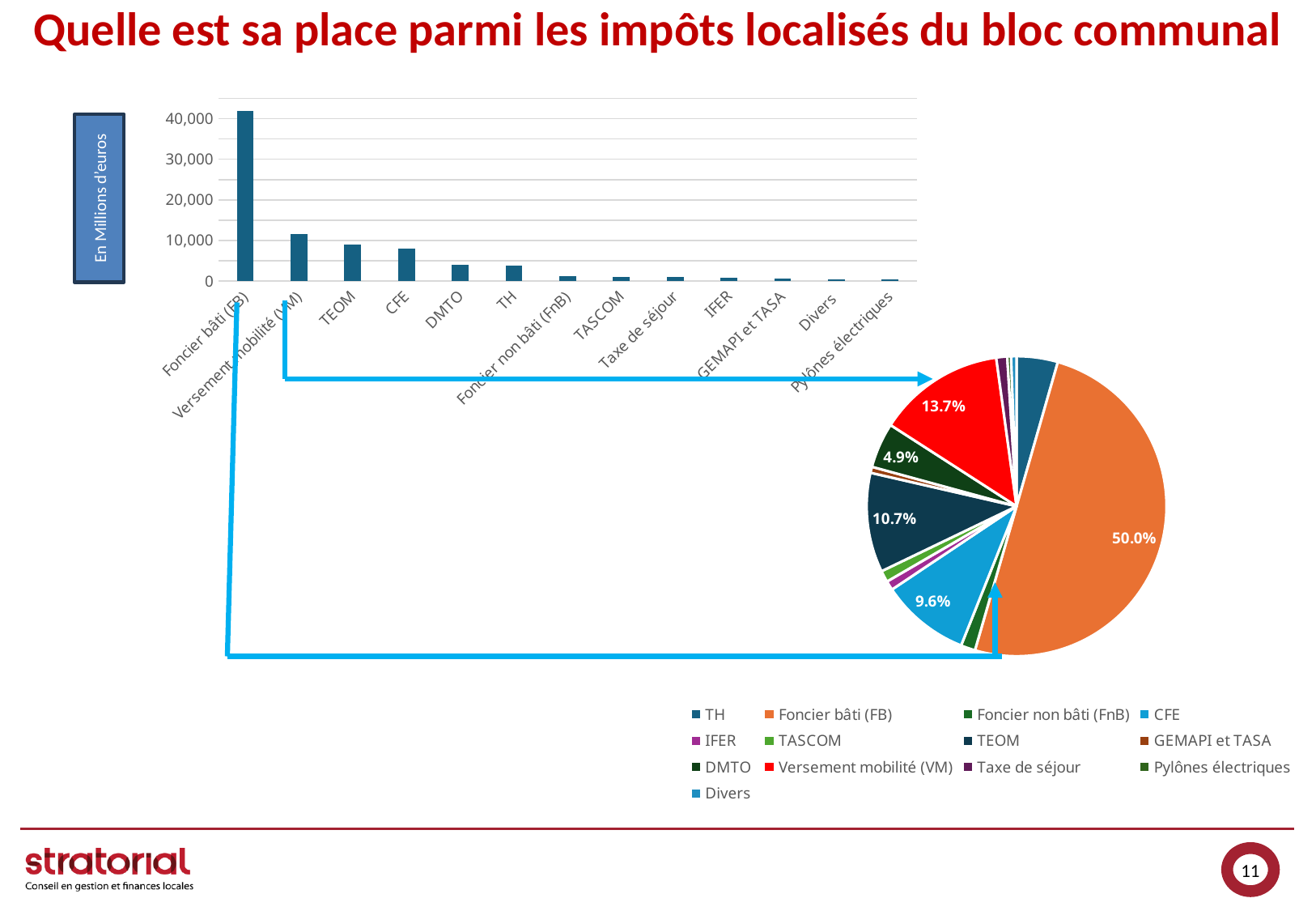
In the pie chart, what share does Versement mobilité (VM) represent? 13.7% What kind of chart is the chart at the bottom right of the slide? pie chart In the top bar chart, how many categories are shown on the x axis? 13 In the top bar chart, which is larger, the value for CFE or the value for DMTO? CFE In the top bar chart, is the value for TEOM greater or less than 10,000? less In the top bar chart, which category has the highest value? Foncier bâti (FB) In the pie chart, what share does Foncier bâti (FB) represent? 50.0% In the pie chart, what is the difference in percentage points between the Foncier bâti (FB) slice and the TEOM slice? 39.3 percentage points How many entries does the legend of the pie chart list? 13 What kind of chart is the top chart on the slide? bar chart In the top bar chart, is the value for Foncier bâti (FB) greater or less than 40,000? greater In the top bar chart, is the value for Versement mobilité (VM) greater or less than 10,000? greater